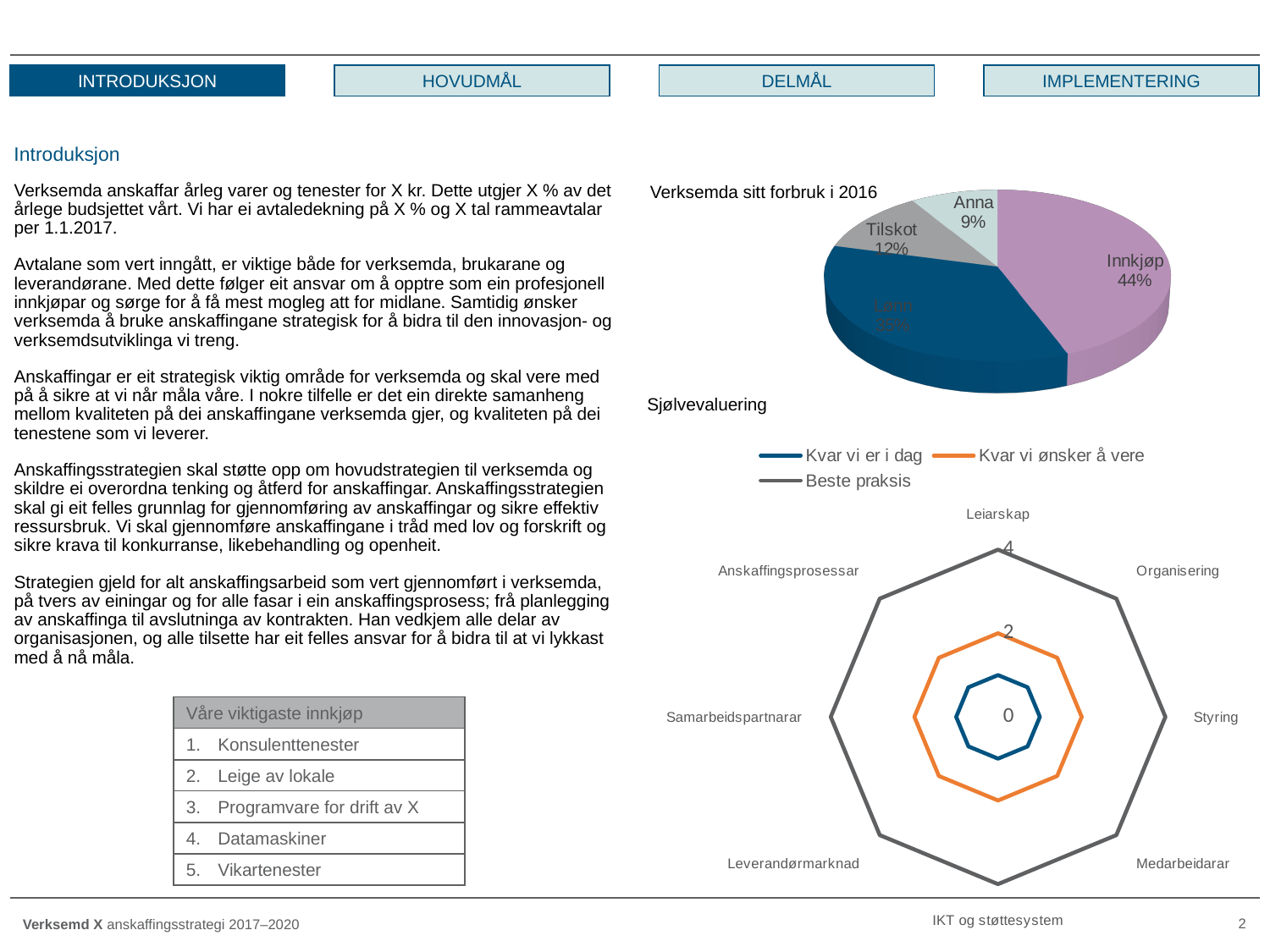
On the pie chart 'Verksemda sitt forbruk i 2016', which labelled slice is the smallest? Anna On the pie chart 'Verksemda sitt forbruk i 2016', what share does Tilskot have? 12% On the 'Sjølvevaluering' chart, is the value of 'Kvar vi er i dag' for Leiarskap greater or less than 2? less On the pie chart 'Verksemda sitt forbruk i 2016', what share does Innkjøp have? 44% On the pie chart 'Verksemda sitt forbruk i 2016', what share does Anna have? 9% On the pie chart 'Verksemda sitt forbruk i 2016', which is larger, Tilskot or Anna? Tilskot On the 'Sjølvevaluering' chart, which series forms the outermost line? Beste praksis On the pie chart 'Verksemda sitt forbruk i 2016', how many percentage points larger is Innkjøp than Tilskot? 32 percentage points What kind of chart is the 'Sjølvevaluering' chart? Radar chart On the pie chart 'Verksemda sitt forbruk i 2016', which slice is the largest? Innkjøp How many categories (axes) does the 'Sjølvevaluering' radar chart have? 8 How many series does the legend of the 'Sjølvevaluering' chart list? 3